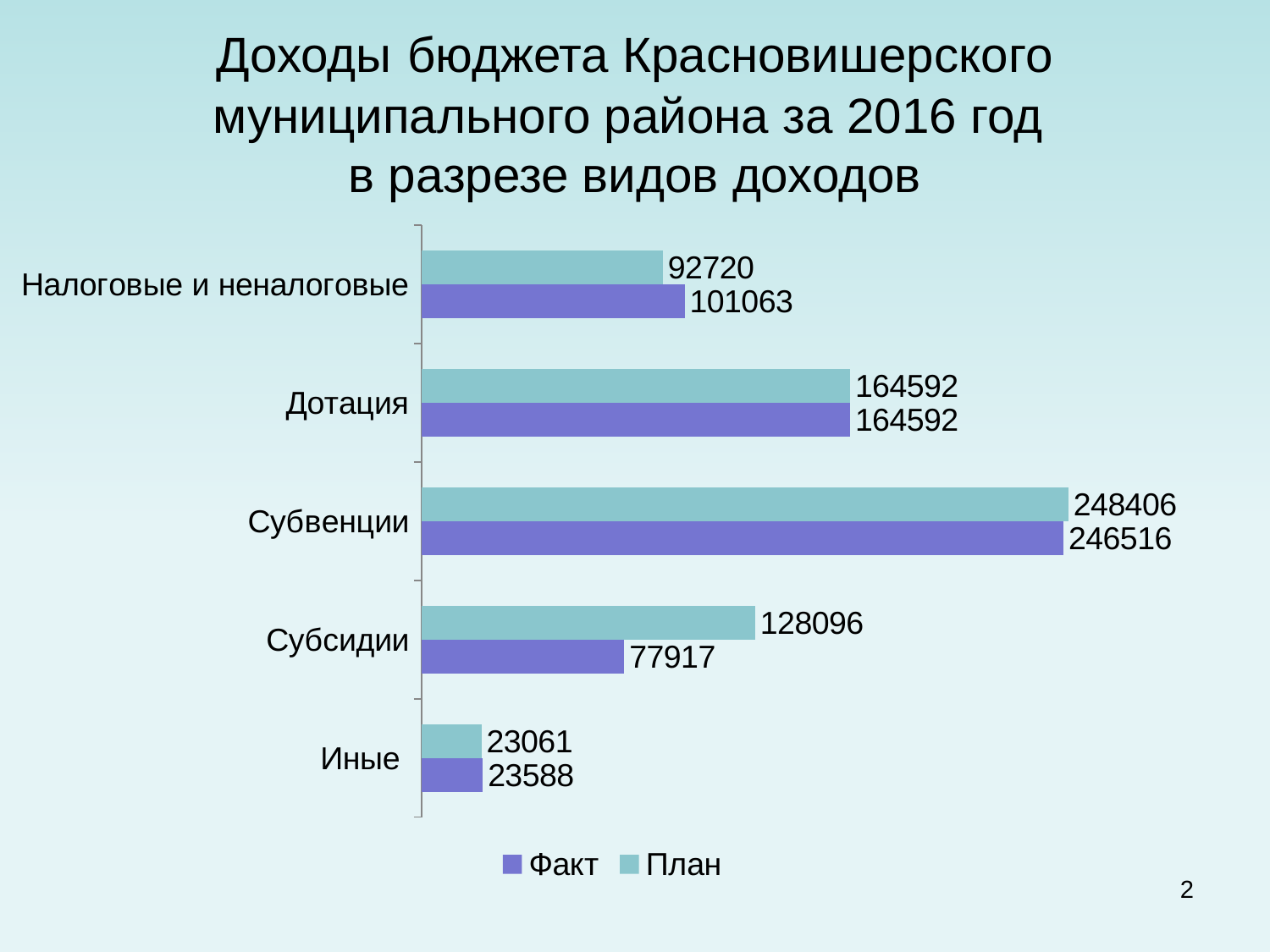
Which category has the lowest Факт value? Иные What is the План value for Налоговые и неналоговые? 92720 How many series does the legend list? 2 Which category has the highest План value? Субвенции What is the Факт value for Иные? 23588 How many categories are shown on the chart? 5 What is the Факт value for Субсидии? 77917 For Налоговые и неналоговые, which is larger: the Факт value or the План value? Факт What is the difference between the План and Факт values for Субвенции? 1890 What kind of chart is shown on the slide? Bar chart Which colour represents the План series in the chart? Teal (light blue) What is the difference between the План and Факт values for Субсидии? 50179